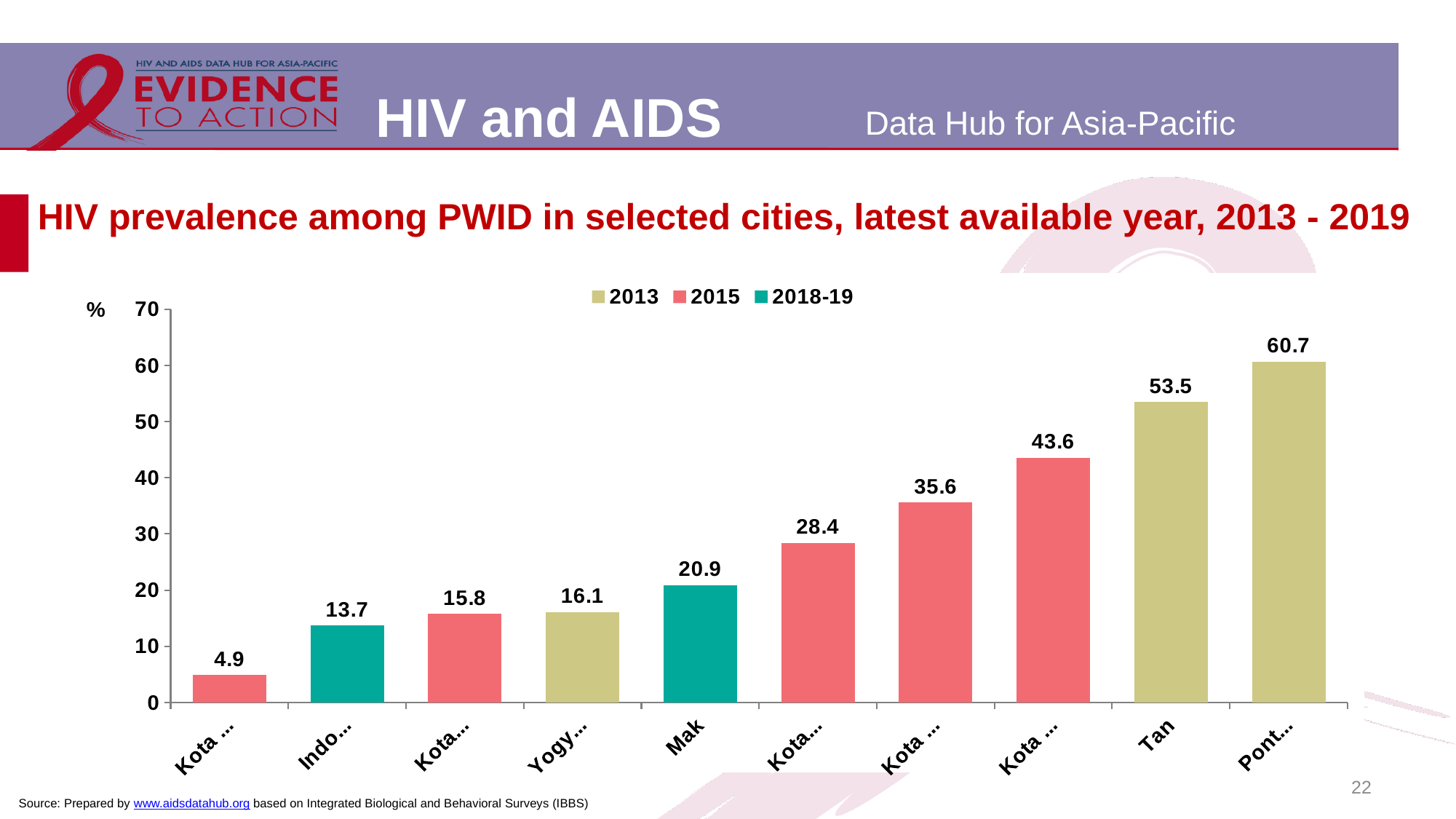
How many series does the legend list? 3 What is the difference between the highest and lowest values shown in the chart? 55.8 Do the bar values rise or fall from left to right along the x axis? rise How many bars belong to the 2015 series? 5 What is the value of the bar labelled "Mak"? 20.9 What is the value of the bar labelled "Tan"? 53.5 Which is larger, the value for "Tan" or the value for "Mak"? Tan What is the highest HIV prevalence value shown in the chart? 60.7 What is the lowest HIV prevalence value shown in the chart? 4.9 Which series does the tallest bar in the chart belong to? 2013 How many bars (cities) are plotted in the chart? 10 What kind of chart is shown on the slide? bar chart